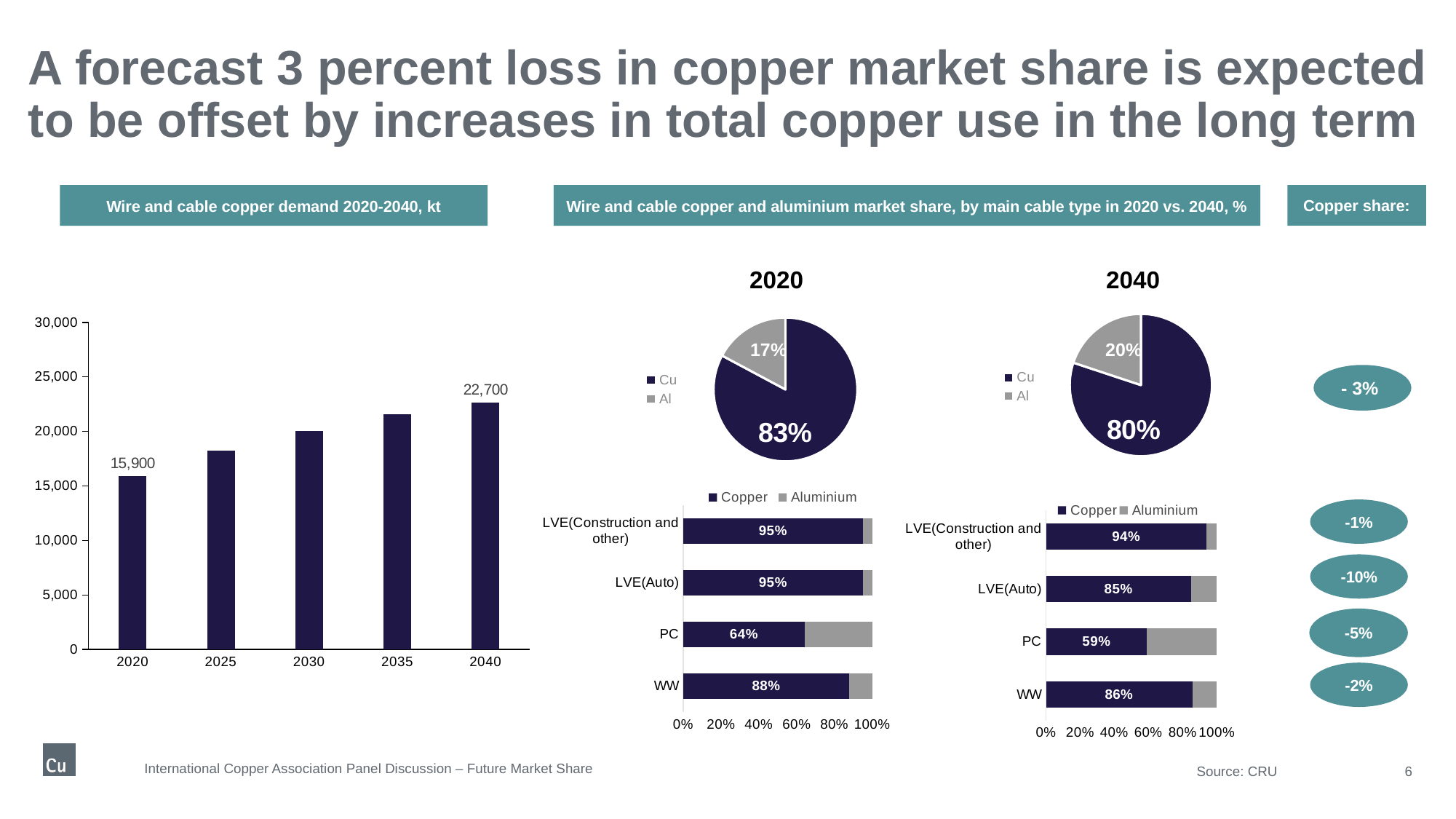
What kind of chart is the 'Wire and cable copper demand 2020-2040, kt' chart? bar chart In the 'Wire and cable copper demand 2020-2040, kt' chart, do the values rise or fall from 2020 to 2040? rise In the 'Wire and cable copper demand 2020-2040, kt' bar chart, what is the difference between the 2040 and 2020 values? 6,800 In the 'Wire and cable copper demand 2020-2040, kt' bar chart, what is the value for 2040? 22,700 In the 2040 stacked bar chart of market share by cable type, which cable type has the lowest Copper share? PC How many series does the legend of the 2020 stacked bar chart of market share by cable type list? 2 How many years are shown on the x axis of the 'Wire and cable copper demand 2020-2040, kt' chart? 5 In the 'Wire and cable copper demand 2020-2040, kt' bar chart, what is the value for 2020? 15,900 In the 2020 stacked bar chart of market share by cable type, what is the Copper share for PC? 64% In the 'Wire and cable copper demand 2020-2040, kt' chart, is the value for 2035 greater or less than 20,000? greater In the 2020 pie chart, what share does Al have? 17% In the 2040 pie chart, what share does Cu have? 80%